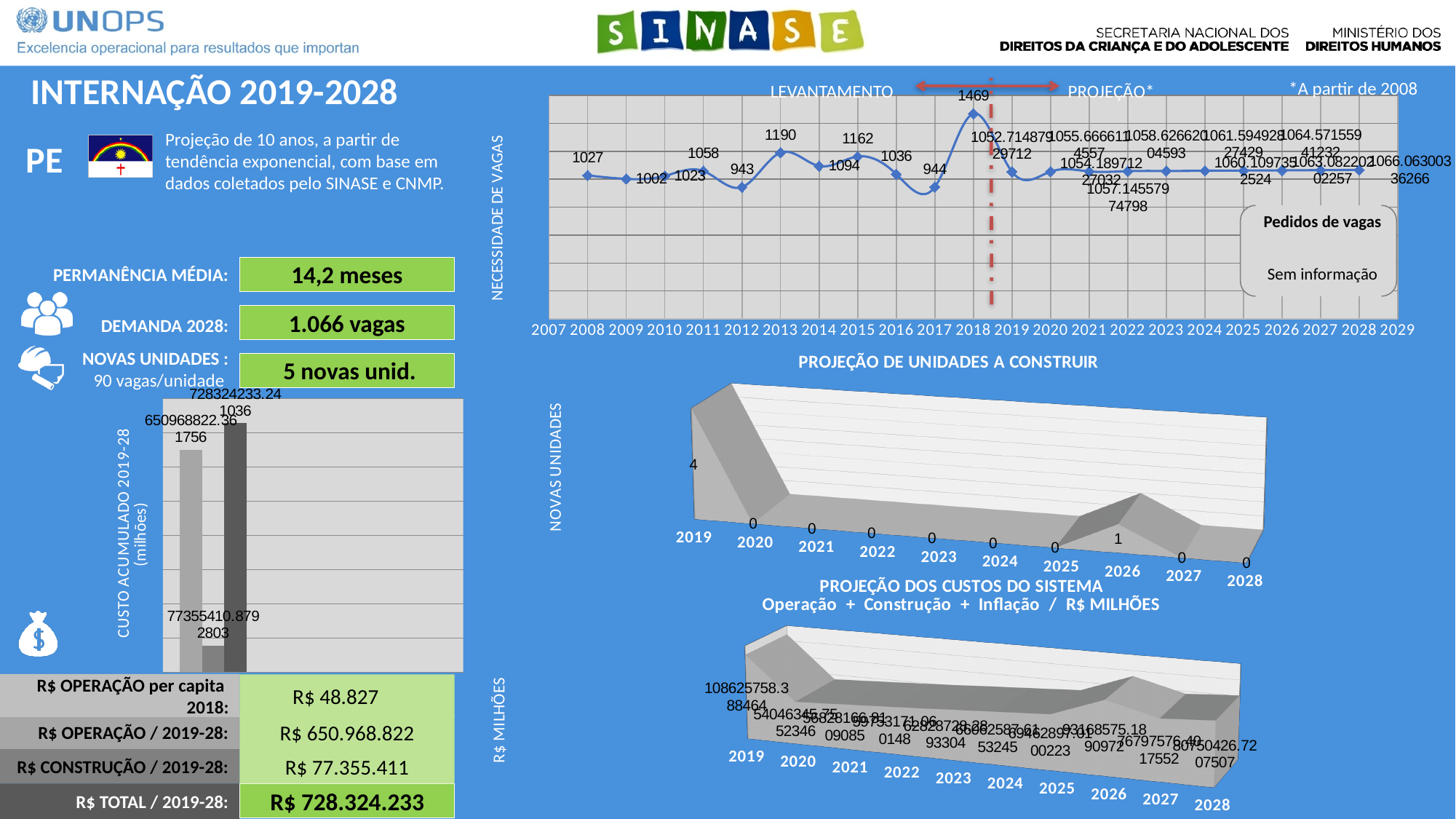
In the top-right line chart (NECESSIDADE DE VAGAS), which year has the highest value? 2018 What kind of chart is the bottom-left chart 'CUSTO ACUMULADO 2019-28 (milhões)'? bar chart In the top-right line chart (NECESSIDADE DE VAGAS), which is larger, the value for 2013 or the value for 2015? 2013 In the chart 'PROJEÇÃO DE UNIDADES A CONSTRUIR', what is the value for 2019? 4 In the chart 'PROJEÇÃO DE UNIDADES A CONSTRUIR', how many years are shown on the x axis? 10 How many bars does the bottom-left chart 'CUSTO ACUMULADO 2019-28 (milhões)' show? 3 In the top-right line chart (NECESSIDADE DE VAGAS), what is the difference between the 2018 value and the 2013 value? 279 In the chart 'PROJEÇÃO DOS CUSTOS DO SISTEMA', which year has the highest value? 2019 What kind of chart is the top-right chart (NECESSIDADE DE VAGAS)? line chart In the chart 'PROJEÇÃO DE UNIDADES A CONSTRUIR', what is the value for 2026? 1 In the top-right line chart (NECESSIDADE DE VAGAS), what is the value for 2013? 1190 In the top-right line chart (NECESSIDADE DE VAGAS), what is the value for 2018? 1469